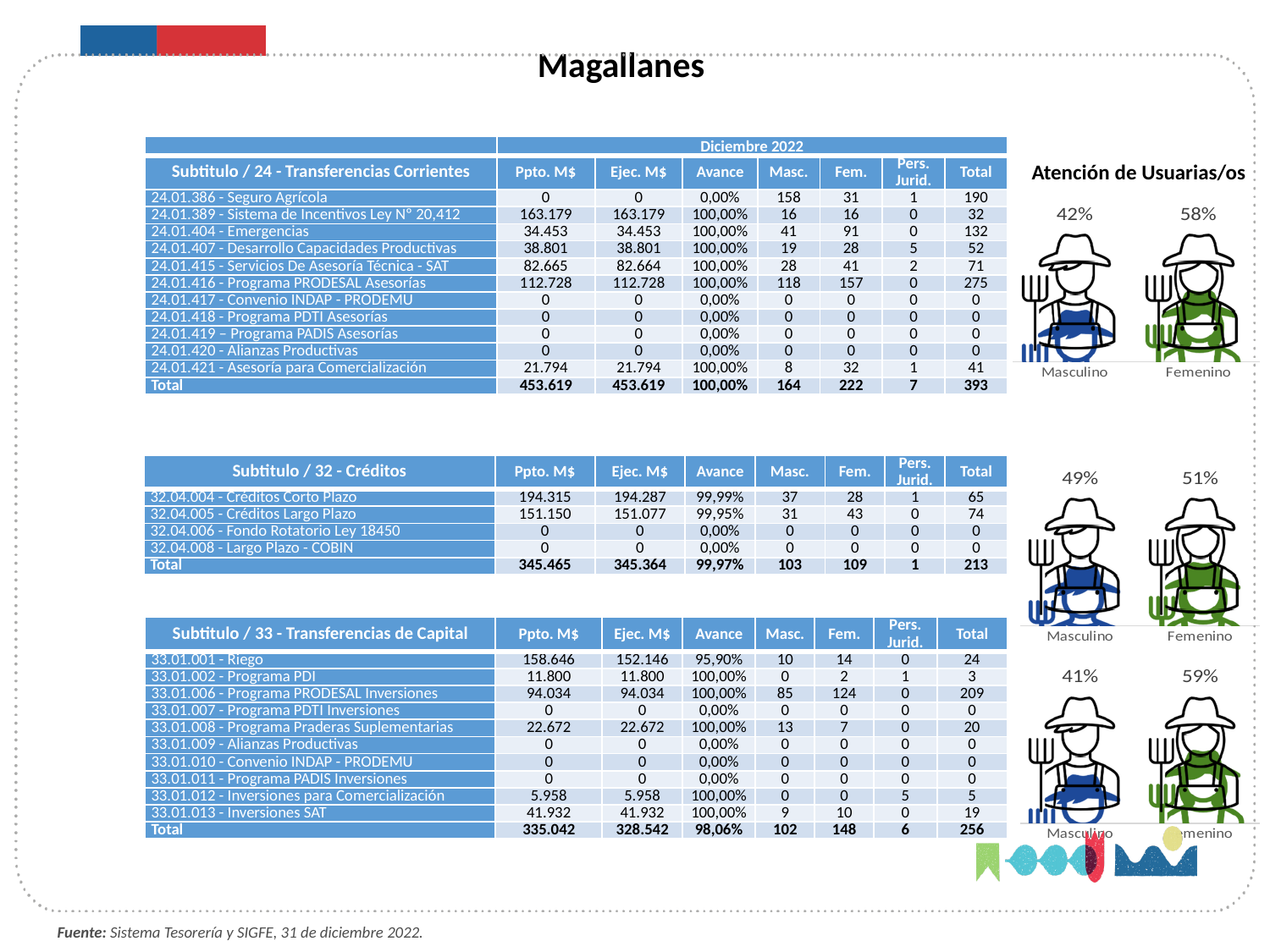
What is the title printed above the top pictograph on the right side of the slide? Atención de Usuarias/os How many categories does each pictograph on the right side of the slide show? 2 In the middle pictograph on the right (next to Subtítulo 32 - Créditos), what percentage is shown for Masculino? 49% In the top 'Atención de Usuarias/os' pictograph, which category has the higher percentage, Masculino or Femenino? Femenino In the top 'Atención de Usuarias/os' pictograph on the right, what percentage is shown for Masculino? 42% In the top 'Atención de Usuarias/os' pictograph, what is the difference between the Femenino and Masculino percentages? 16% In the top 'Atención de Usuarias/os' pictograph on the right, what percentage is shown for Femenino? 58% In the bottom pictograph on the right (next to Subtítulo 33 - Transferencias de Capital), what percentage is shown for Masculino? 41% In the bottom pictograph on the right (next to Subtítulo 33 - Transferencias de Capital), what percentage is shown for Femenino? 59% In the bottom pictograph on the right, which category has the lower percentage? Masculino In the middle pictograph on the right (next to Subtítulo 32 - Créditos), what percentage is shown for Femenino? 51% In the bottom pictograph on the right, what is the difference between the Femenino and Masculino percentages? 18%